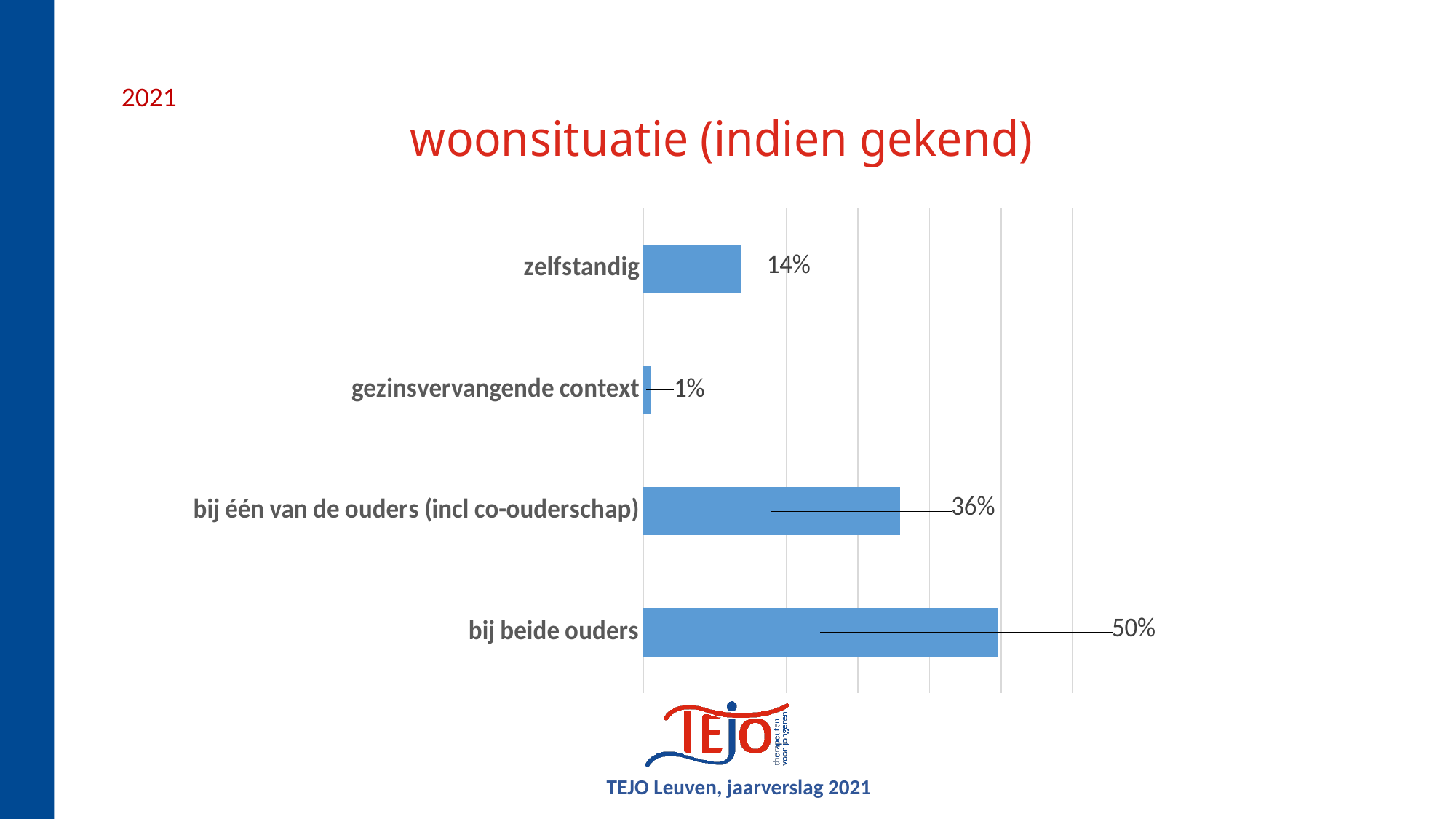
What kind of chart is shown on the slide? bar chart What is the value for 'bij één van de ouders (incl co-ouderschap)'? 36% Which category has the lowest value? gezinsvervangende context How many categories are shown in the chart? 4 Which category has the highest value? bij beide ouders What is the difference between 'zelfstandig' and 'gezinsvervangende context'? 13% What is the value for 'gezinsvervangende context'? 1% What is the value for 'bij beide ouders'? 50% Which is larger, 'zelfstandig' or 'bij één van de ouders (incl co-ouderschap)'? bij één van de ouders (incl co-ouderschap) What is the value for 'zelfstandig'? 14% What is the title of the chart? woonsituatie (indien gekend) What is the difference between 'bij beide ouders' and 'bij één van de ouders (incl co-ouderschap)'? 14%